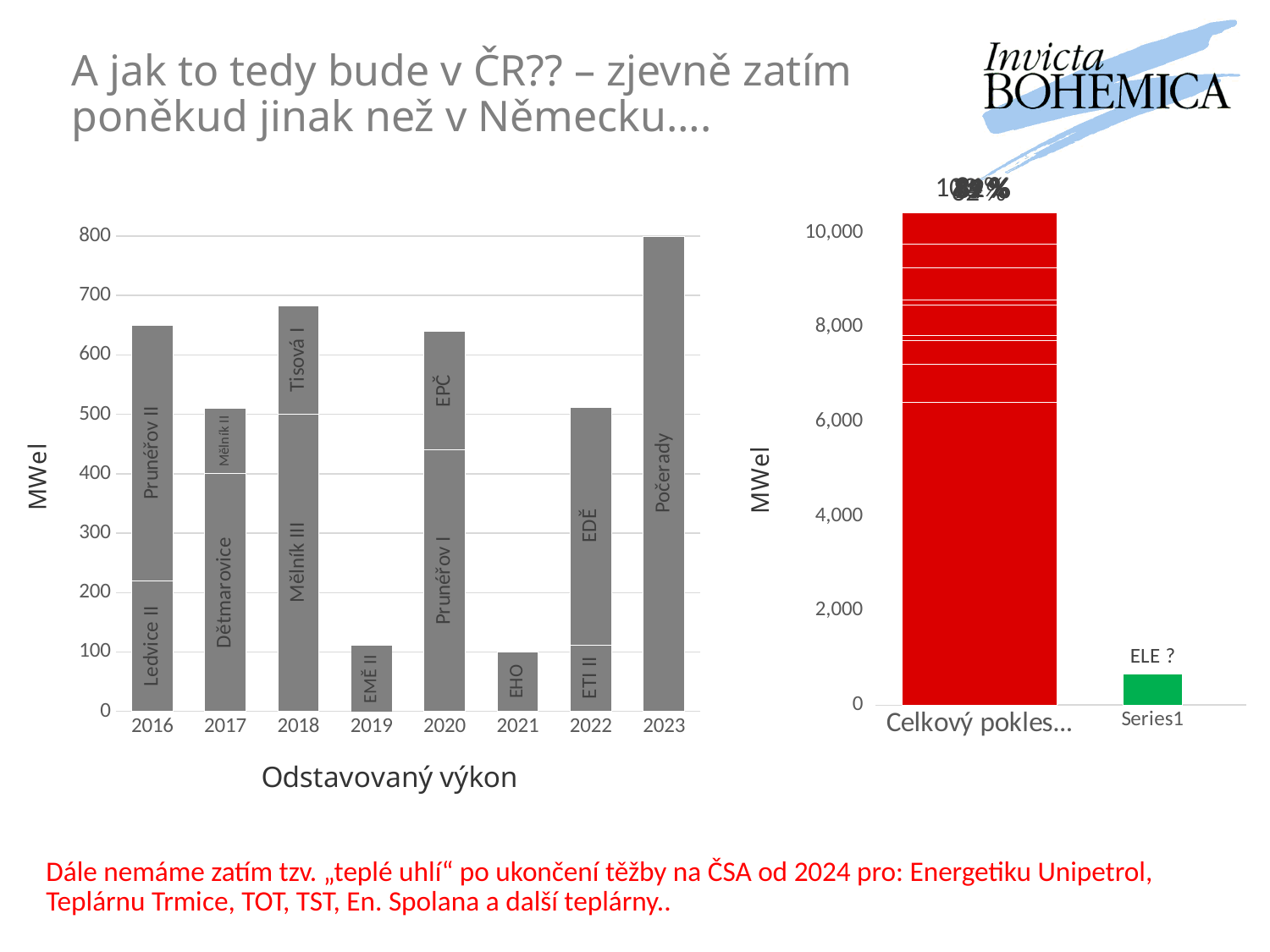
In the left chart 'Odstavovaný výkon', which plant is labelled on the bar for 2023? Počerady In the left chart 'Odstavovaný výkon', which year has the larger total value, 2017 or 2018? 2018 In the left chart 'Odstavovaný výkon', which year has the highest total value? 2023 In the left chart 'Odstavovaný výkon', is the value for 2019 greater or less than 200? less In the left chart 'Odstavovaný výkon', is the total value for 2016 greater or less than 600? greater What kind of chart is the left chart titled 'Odstavovaný výkon'? bar chart In the right chart, which bar is taller, 'Celkový pokles...' or 'Series1'? Celkový pokles... In the left chart 'Odstavovaný výkon', which year has the larger value, 2019 or 2022? 2022 What is the y-axis label of the left chart 'Odstavovaný výkon'? MWel In the left chart 'Odstavovaný výkon', is the total value for 2022 greater or less than 400? greater In the left chart 'Odstavovaný výkon', how many years are shown on the x axis? 8